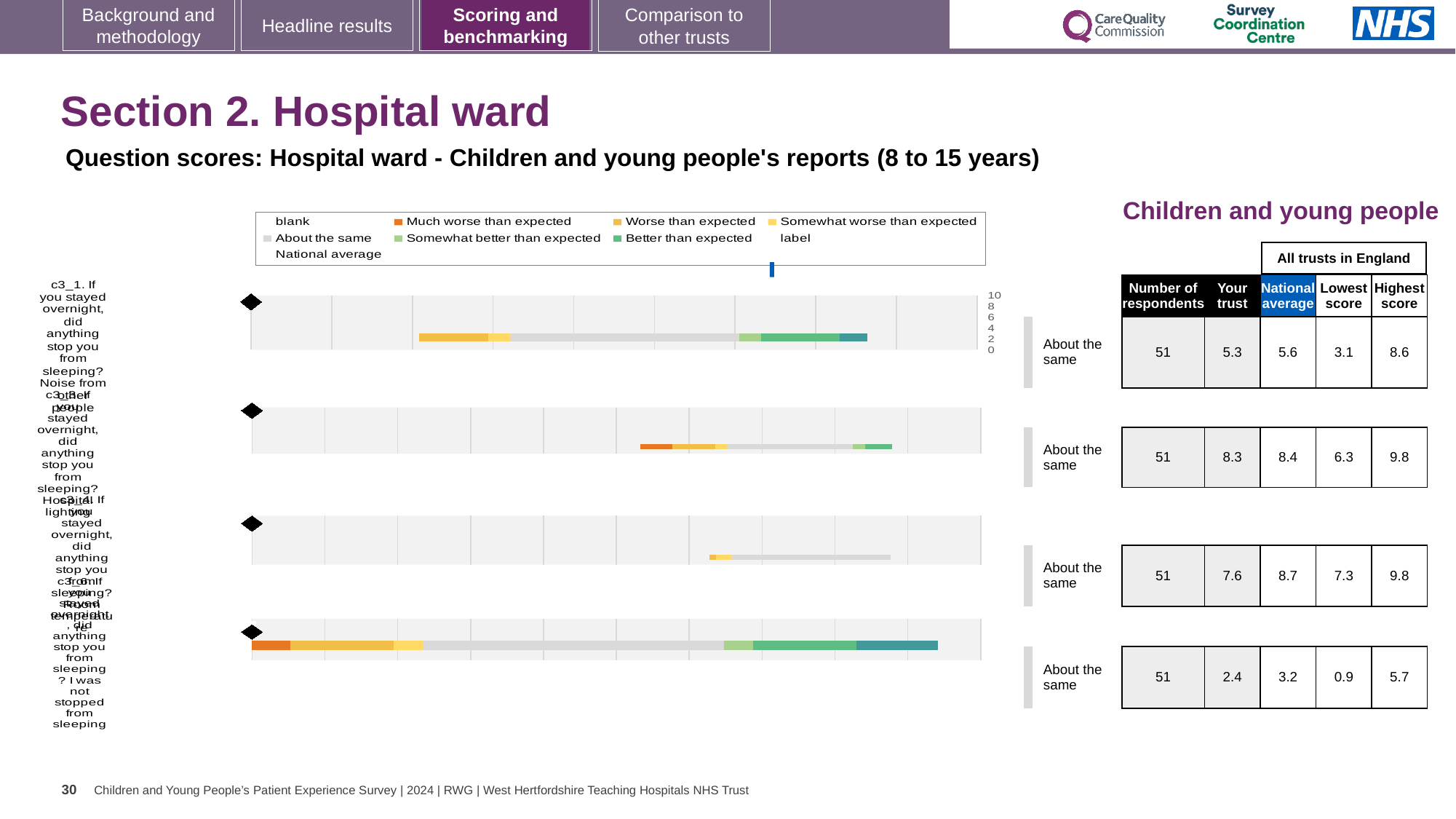
For the third chart (c3_4), which is larger: the 'Your trust' score or the national average? National average How many respondents are reported for the top chart (c3_1)? 51 For the top chart (c3_1, noise from other people), what is the 'Your trust' score? 5.3 Which chart row has the highest 'Your trust' score? c3_3 (hospital lighting), 8.3 For the top chart (c3_1), what is the difference between the highest score and the lowest score? 5.5 For the second chart (c3_3, hospital lighting), what is the national average score? 8.4 What is the title of the slide? Section 2. Hospital ward In the legend, which colour represents 'Much worse than expected'? orange How many question rows (bar charts) are shown on the slide? 4 For the bottom chart (c3_6, I was not stopped from sleeping), what is the highest score among all trusts in England? 5.7 What kind of chart is used to show the question scores on this slide? bar chart How many entries does the chart legend list? 9